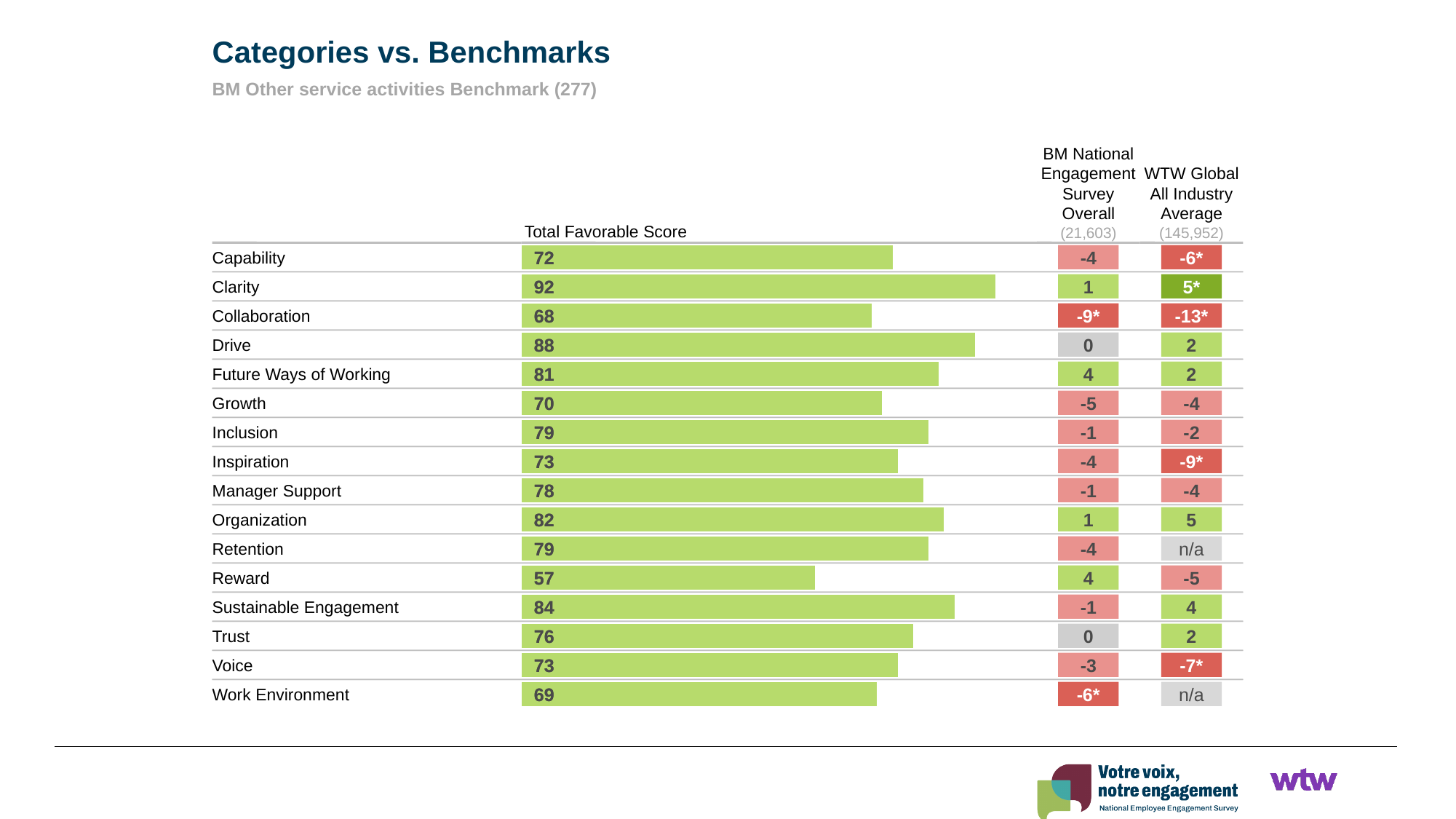
What is the Total Favorable Score for Clarity? 92 Which has a higher Total Favorable Score, Organization or Inclusion? Organization How many categories are shown in the chart? 16 What is the Total Favorable Score for Reward? 57 What is the title of the slide? Categories vs. Benchmarks What kind of chart is used to show the Total Favorable Score? Bar chart What is the difference between the Total Favorable Scores for Clarity and Reward? 35 Which has a higher Total Favorable Score, Growth or Trust? Trust What is the difference between the Total Favorable Scores for Drive and Collaboration? 20 Which category has the highest Total Favorable Score? Clarity What is the Total Favorable Score for Sustainable Engagement? 84 Which category has the lowest Total Favorable Score? Reward